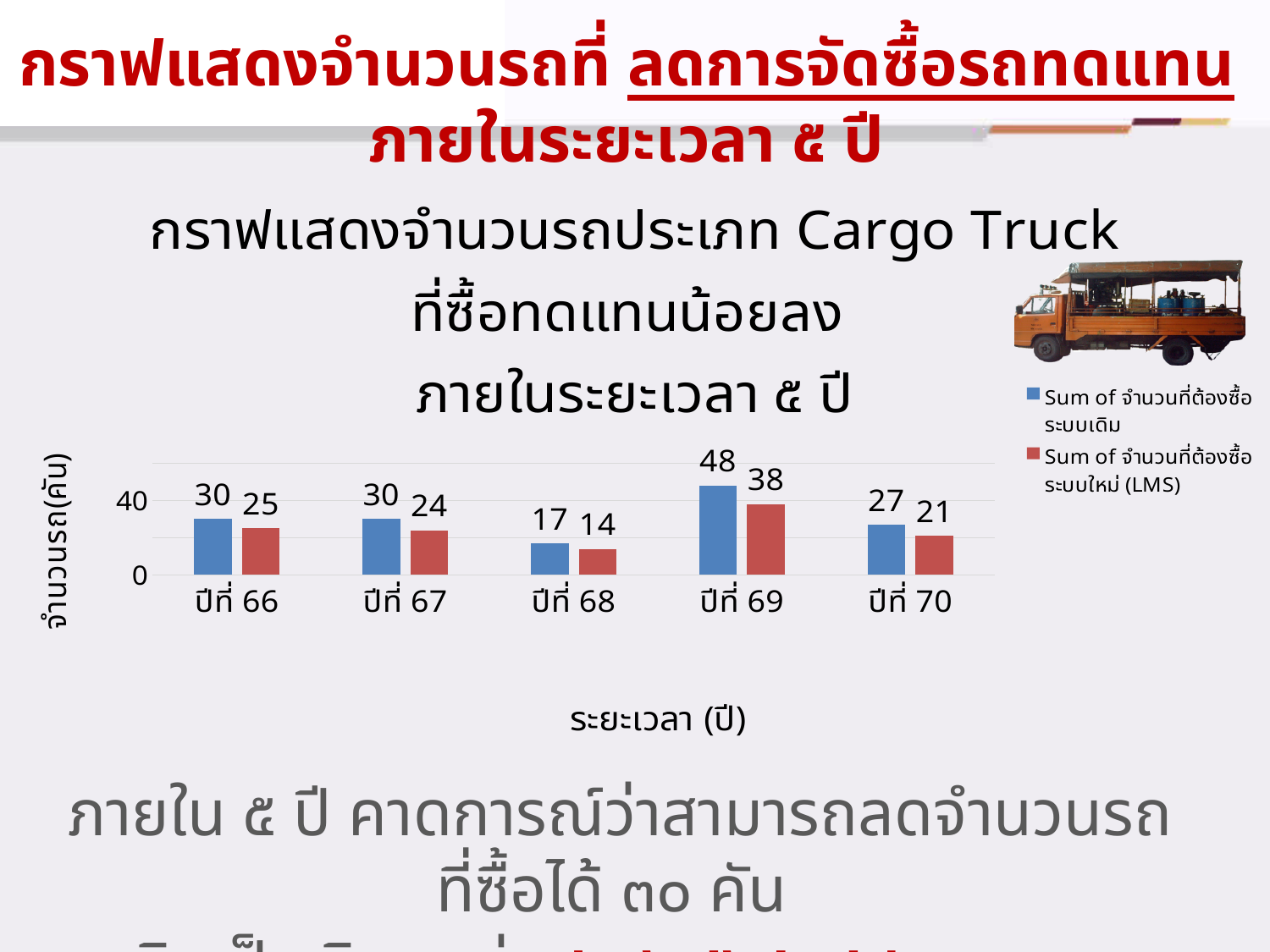
What is the label of the y axis? จำนวนรถ(คัน) What is the value of the ระบบใหม่ (LMS) series for ปีที่ 70? 21 Which year has the lowest value for the ระบบใหม่ (LMS) series? ปีที่ 68 What is the value of the ระบบใหม่ (LMS) (red) series for ปีที่ 68? 14 Is the ระบบเดิม value for ปีที่ 69 greater or less than 40? greater Which year has the highest value for the ระบบเดิม series? ปีที่ 69 Which is larger for ปีที่ 67: the ระบบเดิม value or the ระบบใหม่ (LMS) value? ระบบเดิม What is the value of the ระบบเดิม (blue) series for ปีที่ 69? 48 How many year categories are shown on the x axis? 5 How many series does the legend list? 2 What is the difference between the ระบบเดิม and ระบบใหม่ (LMS) values for ปีที่ 69? 10 What type of chart is shown on the slide? bar chart